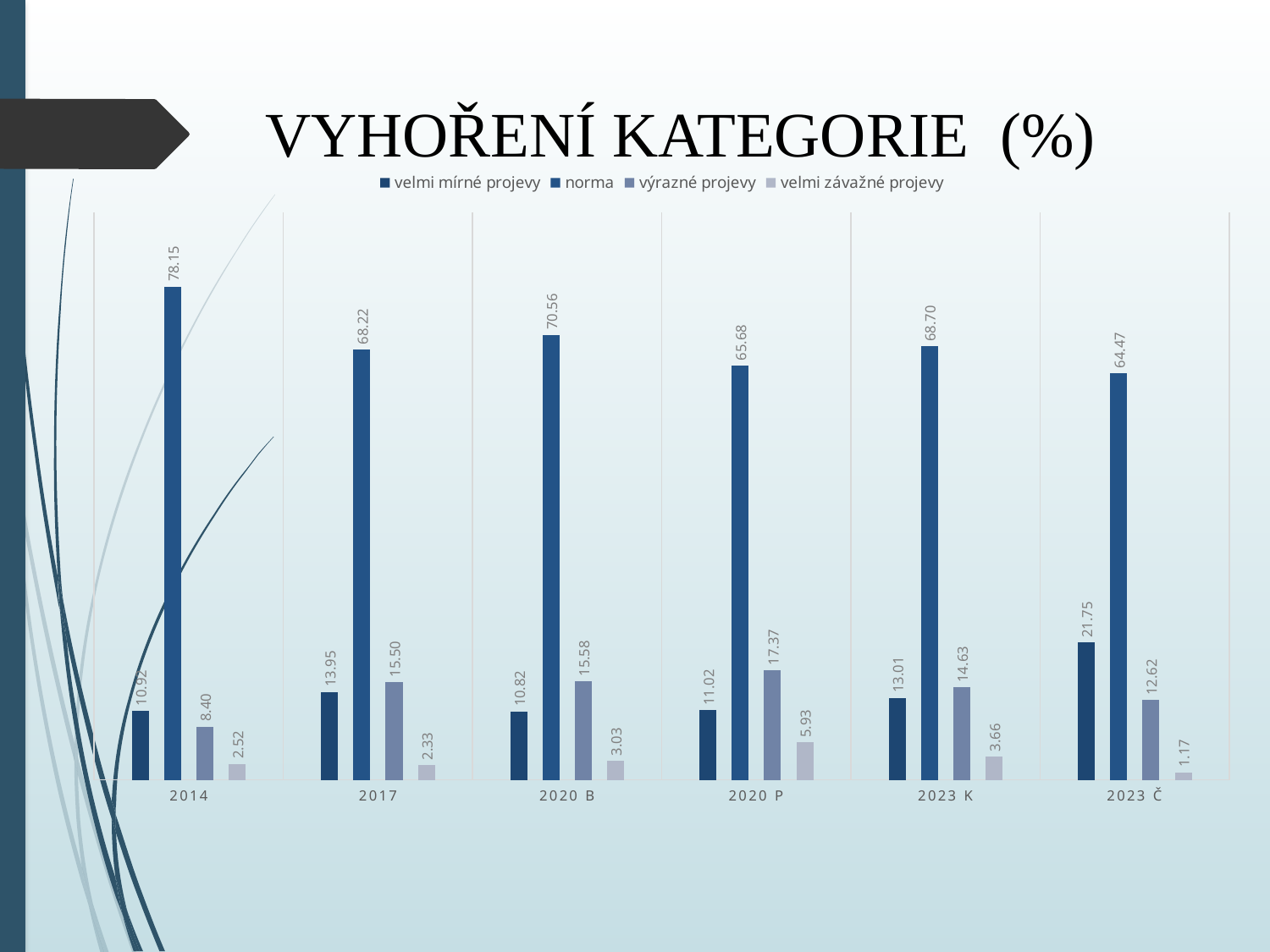
Which is larger: "výrazné projevy" for 2017 or for 2023 K? 2017 Which category has the highest value for "velmi mírné projevy"? 2023 Č What is the value of "velmi závažné projevy" for 2023 Č? 1.17 Which category has the lowest value for "velmi závažné projevy"? 2023 Č What is the value of "velmi mírné projevy" for 2017? 13.95 How many series does the legend list? 4 What is the value of "výrazné projevy" for 2020 P? 17.37 What is the difference between the "norma" values for 2014 and 2023 Č? 13.68 How many categories are shown on the x axis? 6 What kind of chart is shown on the slide? Bar chart Which category has the highest value for the "norma" series? 2014 What is the value of the "norma" series for 2014? 78.15